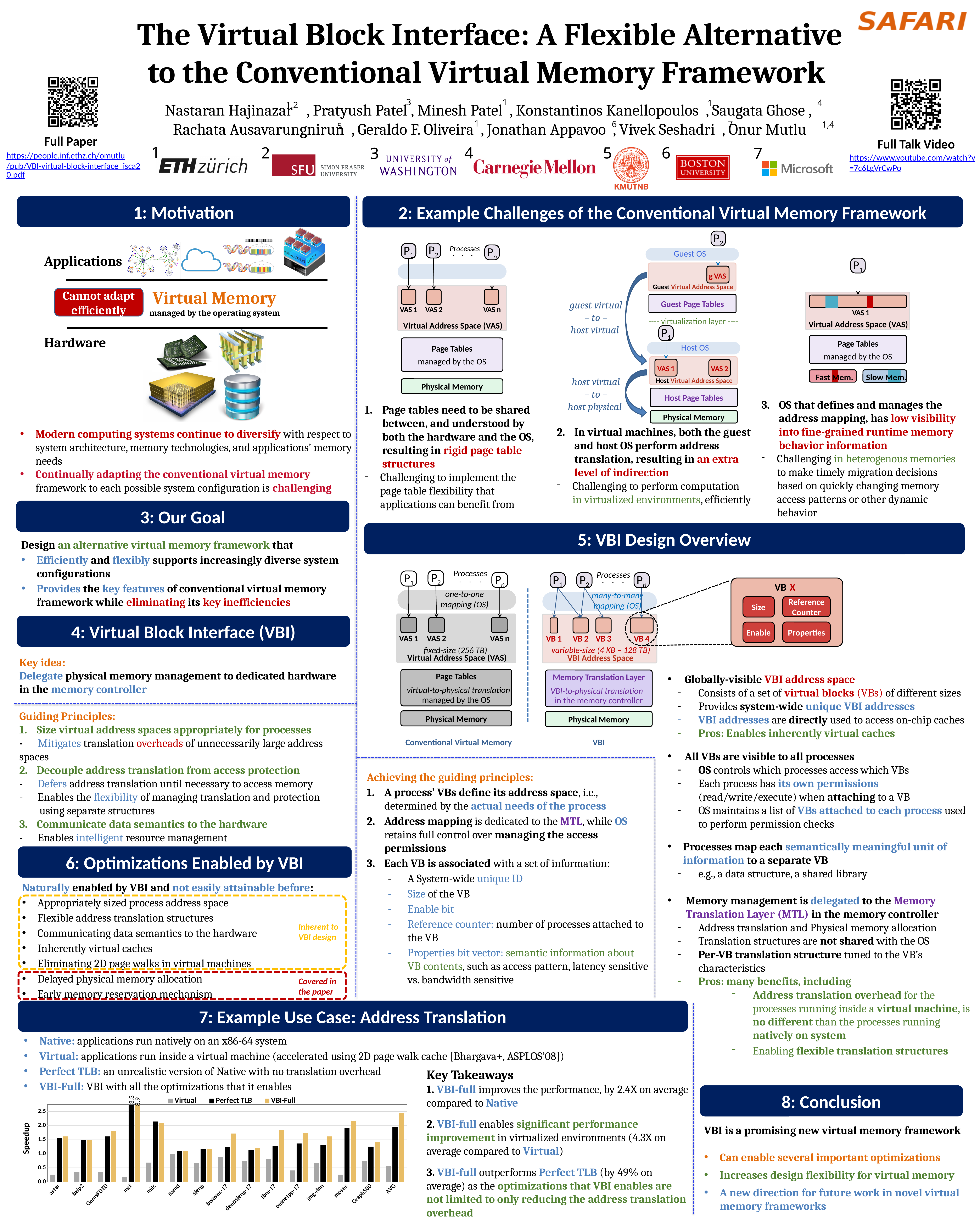
What is the label on the y axis of the chart in section 7? Speedup In the speedup chart, for mcf, which is larger: the VBI-Full bar or the Perfect TLB bar? VBI-Full In the speedup chart, which benchmark has the highest VBI-Full speedup? mcf In the speedup chart, is the Virtual value for astar greater or less than 0.5? less In the speedup chart, is the VBI-Full value for namd greater or less than 1.5? less How many categories (benchmarks, including AVG) are shown on the x axis of the speedup chart? 15 How many series does the legend of the speedup chart list? 3 In the speedup chart, is the VBI-Full value for AVG greater or less than 2.0? greater What kind of chart is shown in section 7 (Example Use Case: Address Translation)? bar chart